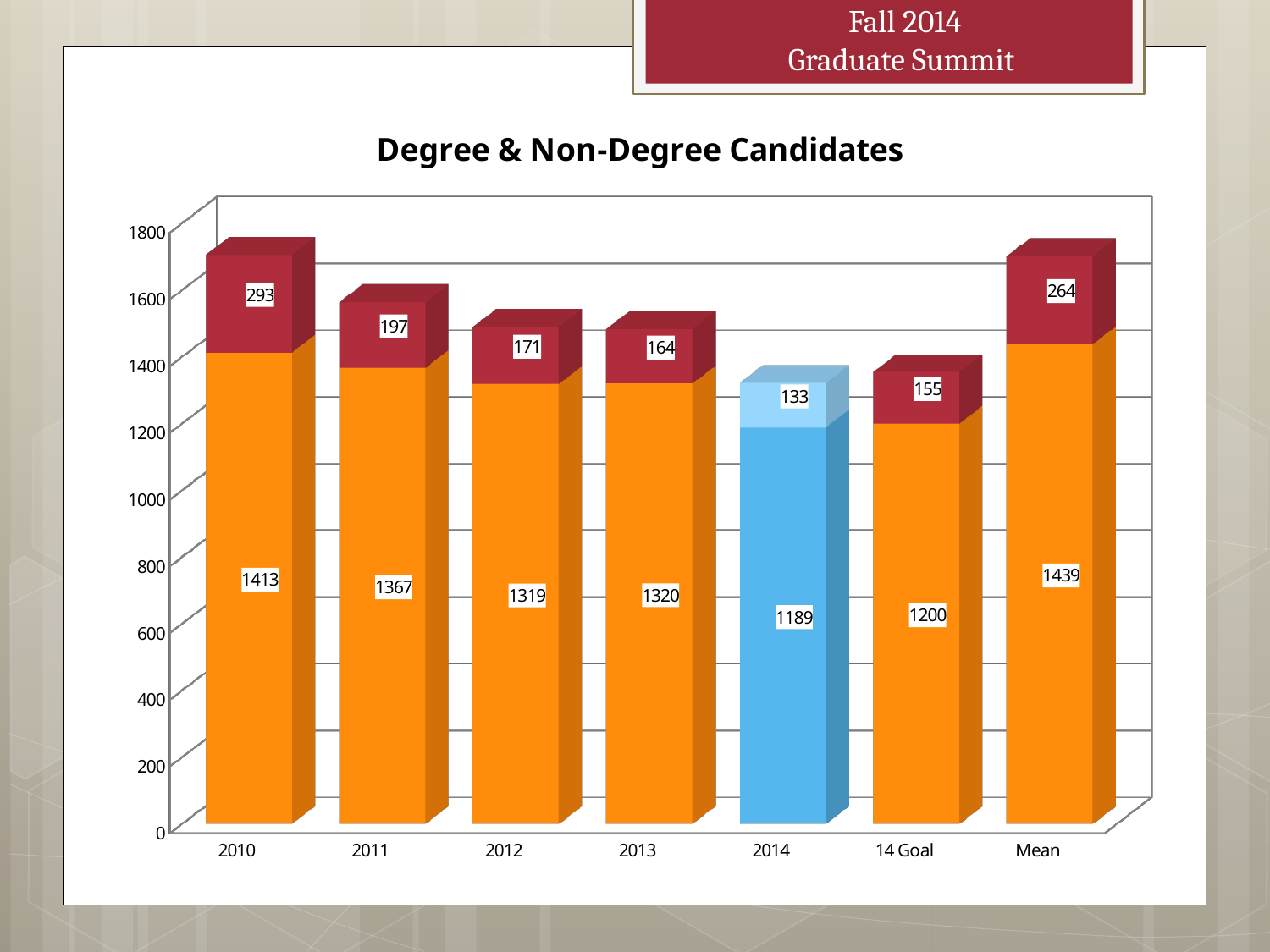
What is the value of the bottom (orange) segment of the 2010 bar? 1413 What is the value of the bottom segment of the Mean bar? 1439 Which has the larger top segment, 2012 or 2013? 2012 What is the difference between the top segment values for Mean and 14 Goal? 109 What is the total of the stacked bar for 2014? 1322 What is the difference between the bottom segment values for 2010 and 2011? 46 What is the title of the chart? Degree & Non-Degree Candidates What kind of chart is shown on the slide? Stacked bar chart Which category has the smallest bottom segment? 2014 What is the value of the top (light blue) segment of the 2014 bar? 133 Which category has the largest top (dark red) segment? 2010 How many categories are shown on the x axis? 7